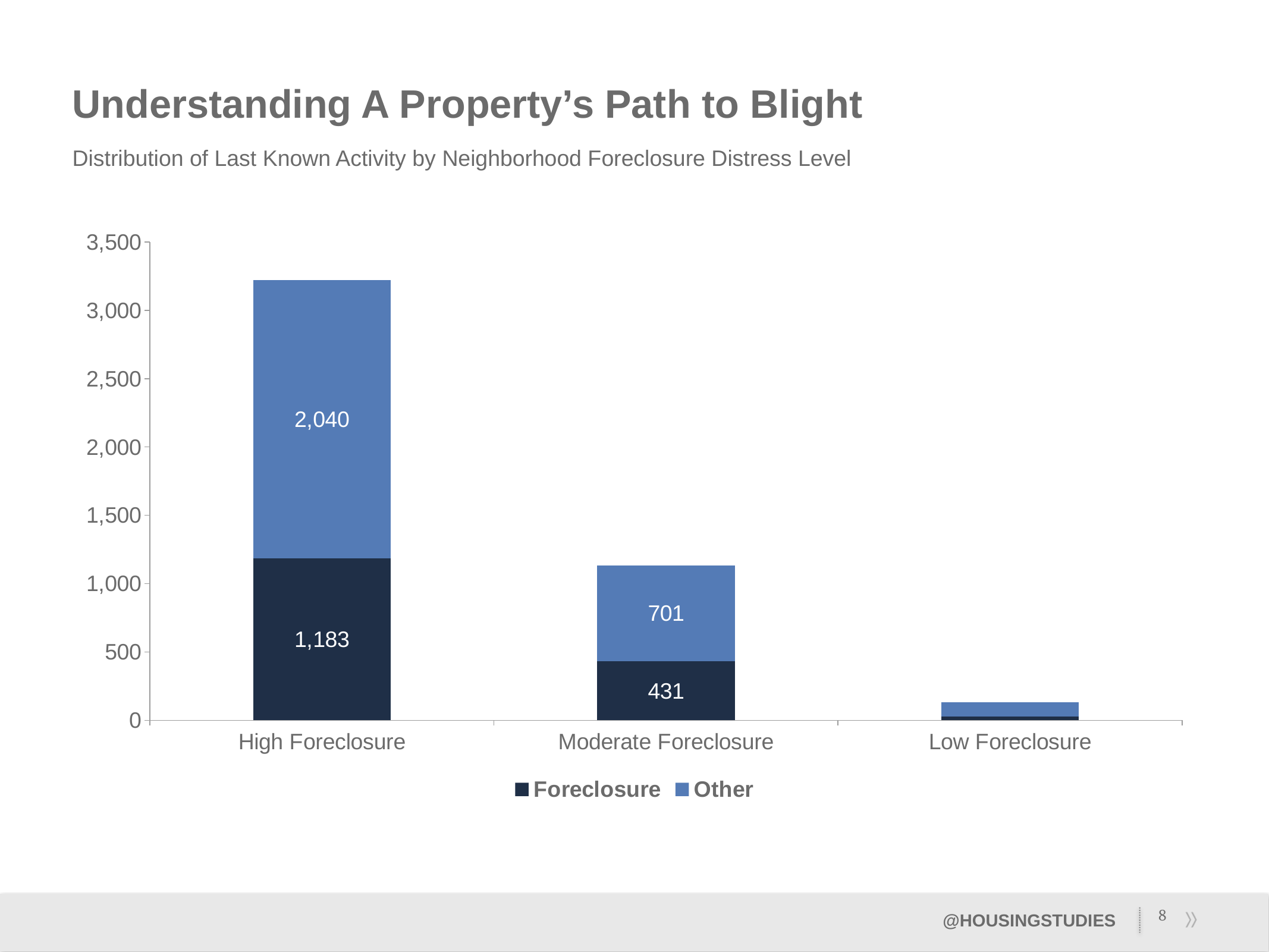
What is the Other value for High Foreclosure? 2,040 Which category has the lowest total stacked bar? Low Foreclosure What is the total of the stacked bar for Moderate Foreclosure? 1,132 What is the difference between the Other value and the Foreclosure value for High Foreclosure? 857 What is the Other value for Moderate Foreclosure? 701 What is the Foreclosure value for Moderate Foreclosure? 431 What is the Foreclosure value for High Foreclosure? 1,183 Is the total stacked bar for Low Foreclosure greater or less than 500? less What kind of chart is shown on the slide? Stacked bar chart How many categories are shown on the x axis? 3 How many series does the legend list? 2 Which category has the highest total stacked bar? High Foreclosure